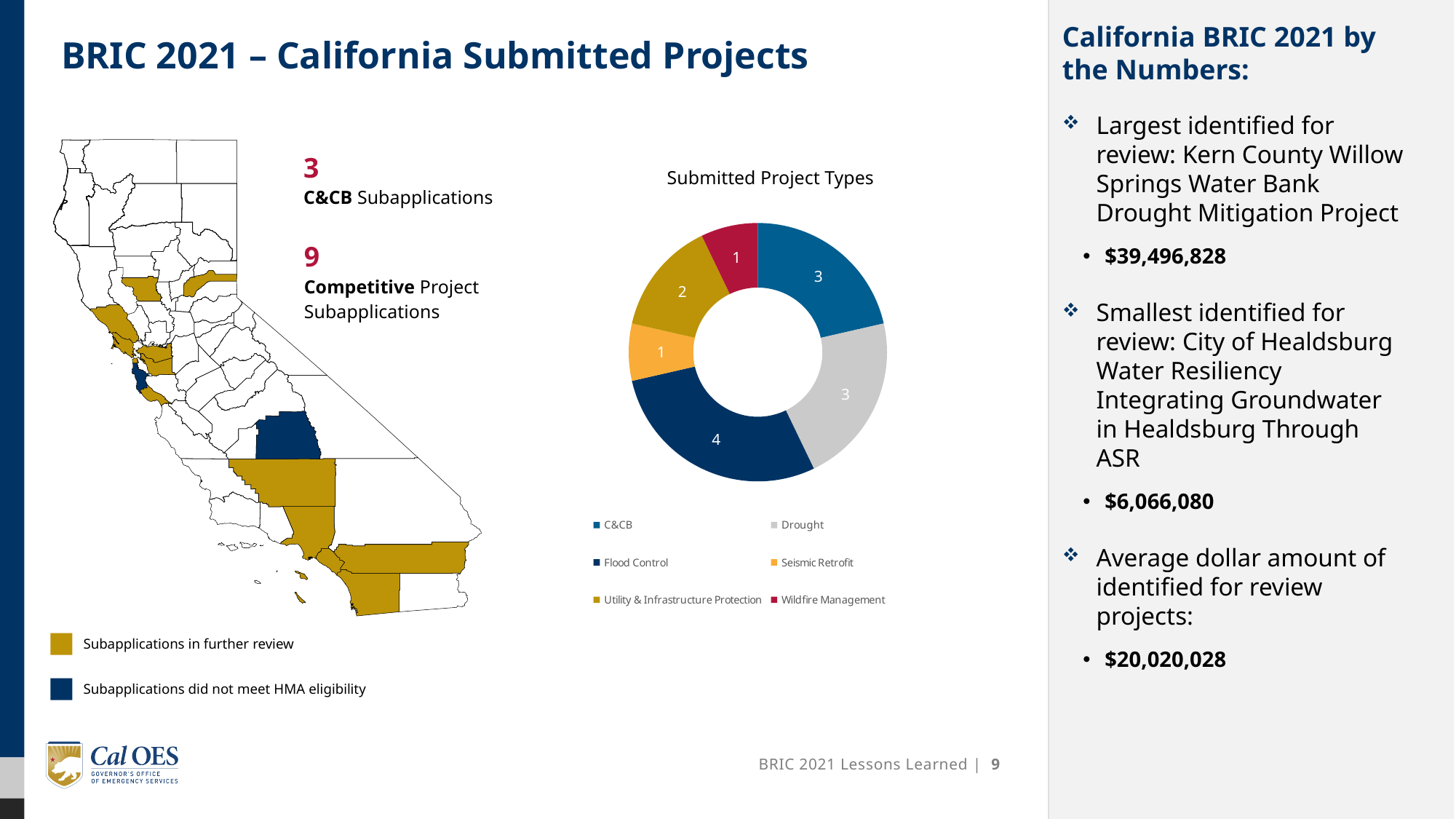
In the "Submitted Project Types" chart, which is larger: Flood Control or Utility & Infrastructure Protection? Flood Control In the "Submitted Project Types" chart, how many projects are Utility & Infrastructure Protection? 2 Which project type has the largest slice in the "Submitted Project Types" chart? Flood Control What is the total number of projects across all slices of the "Submitted Project Types" chart? 14 In the "Submitted Project Types" chart, what is the difference between the Flood Control and Seismic Retrofit values? 3 How many project types are shown in the "Submitted Project Types" chart? 6 In the "Submitted Project Types" chart, how many projects are Flood Control? 4 In the "Submitted Project Types" chart, how many projects are Drought? 3 What colour is the Seismic Retrofit slice in the "Submitted Project Types" chart? Orange In the "Submitted Project Types" chart, how many projects are Wildfire Management? 1 In the "Submitted Project Types" chart, what share of the total do Flood Control projects represent? 4 out of 14 What kind of chart is the "Submitted Project Types" chart? Pie chart (donut)